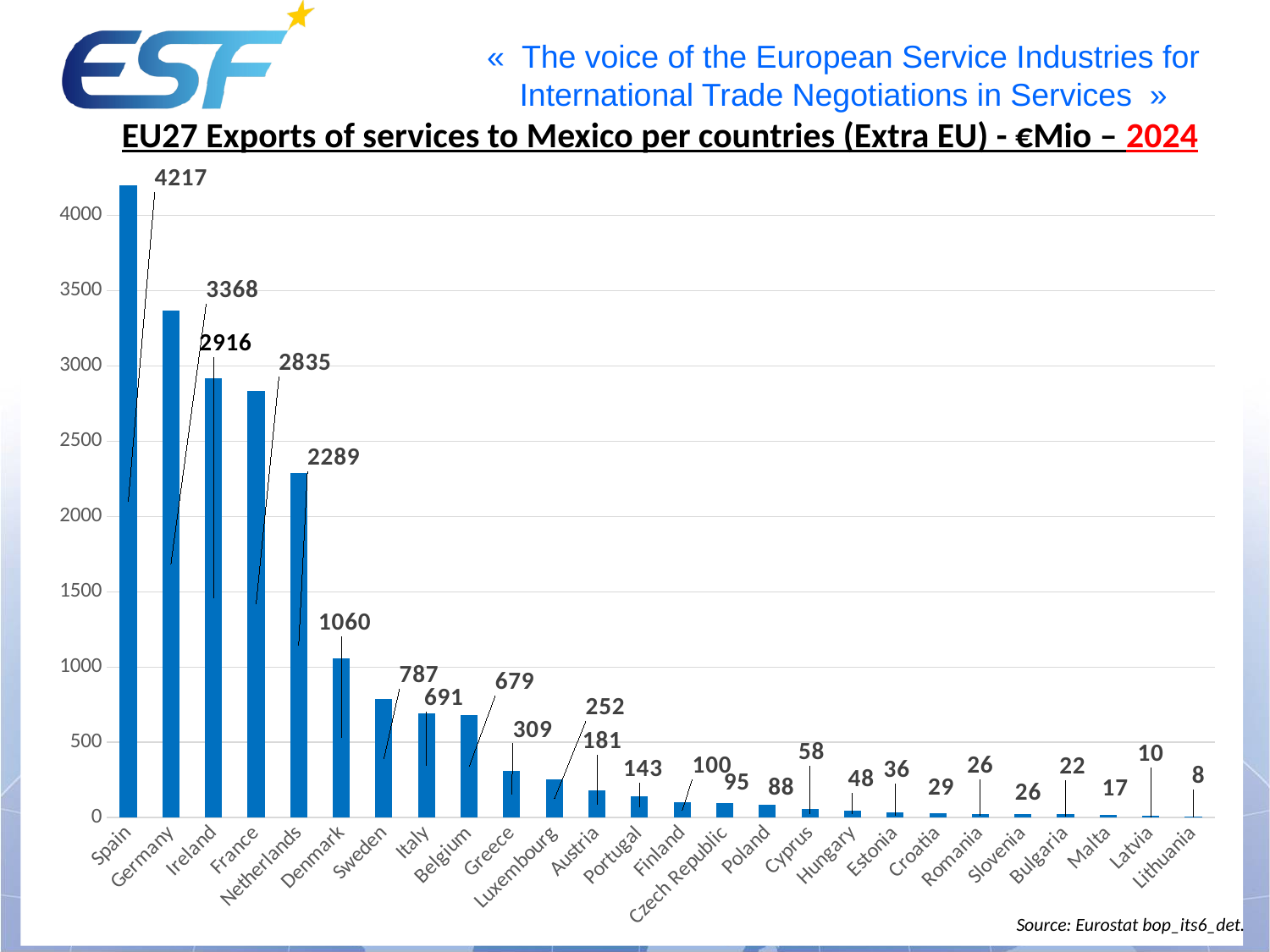
What is the value for Netherlands? 2289 Which country has the lowest value? Lithuania What is the difference between the values for Germany and Ireland? 452 What is the value for Czech Republic? 95 What kind of chart is shown on the slide? Bar chart How many countries are shown on the x axis? 26 Which country has the highest value? Spain What is the value for Luxembourg? 252 Is the value for Denmark greater or less than 1000? greater What is the value for Spain? 4217 Do the values rise or fall from left to right along the x axis? Fall Which is larger, the value for Sweden or the value for Italy? Sweden